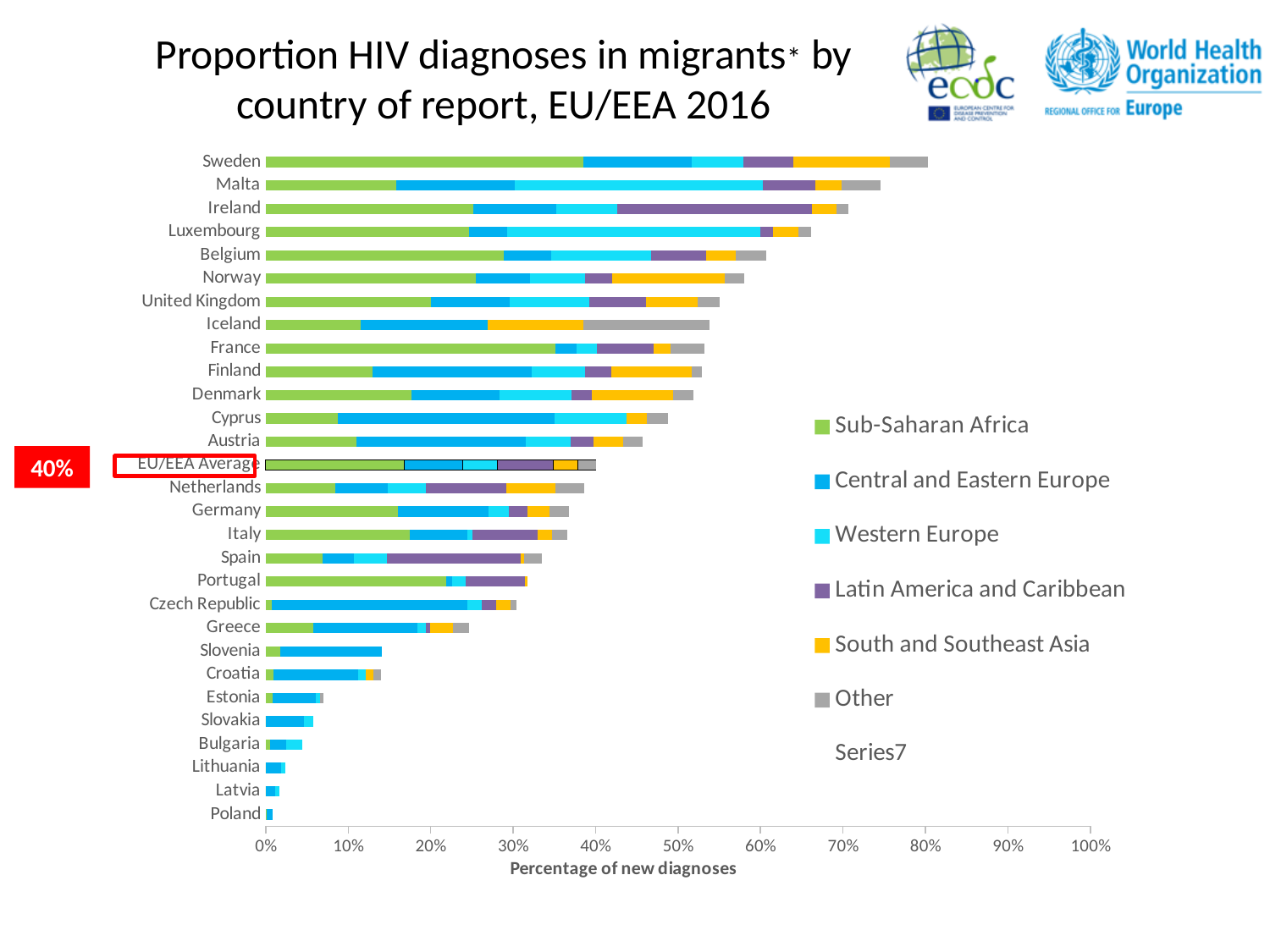
Is the total value for Sweden greater or less than 70%? greater How many bars (countries plus the EU/EEA Average) are plotted on the chart? 29 What kind of chart is shown on the slide? Stacked horizontal bar chart Which colour represents Sub-Saharan Africa in the legend? Green What is the overall proportion shown for the EU/EEA Average? 40% Is the total value for Poland greater or less than 10%? less What is the title of the x axis? Percentage of new diagnoses How many entries does the legend list? 7 Which country has the lowest overall proportion of HIV diagnoses in migrants? Poland Which has a larger total proportion, Malta or Greece? Malta Which country has the highest overall proportion of HIV diagnoses in migrants? Sweden Is the total value for Belgium greater or less than 50%? greater